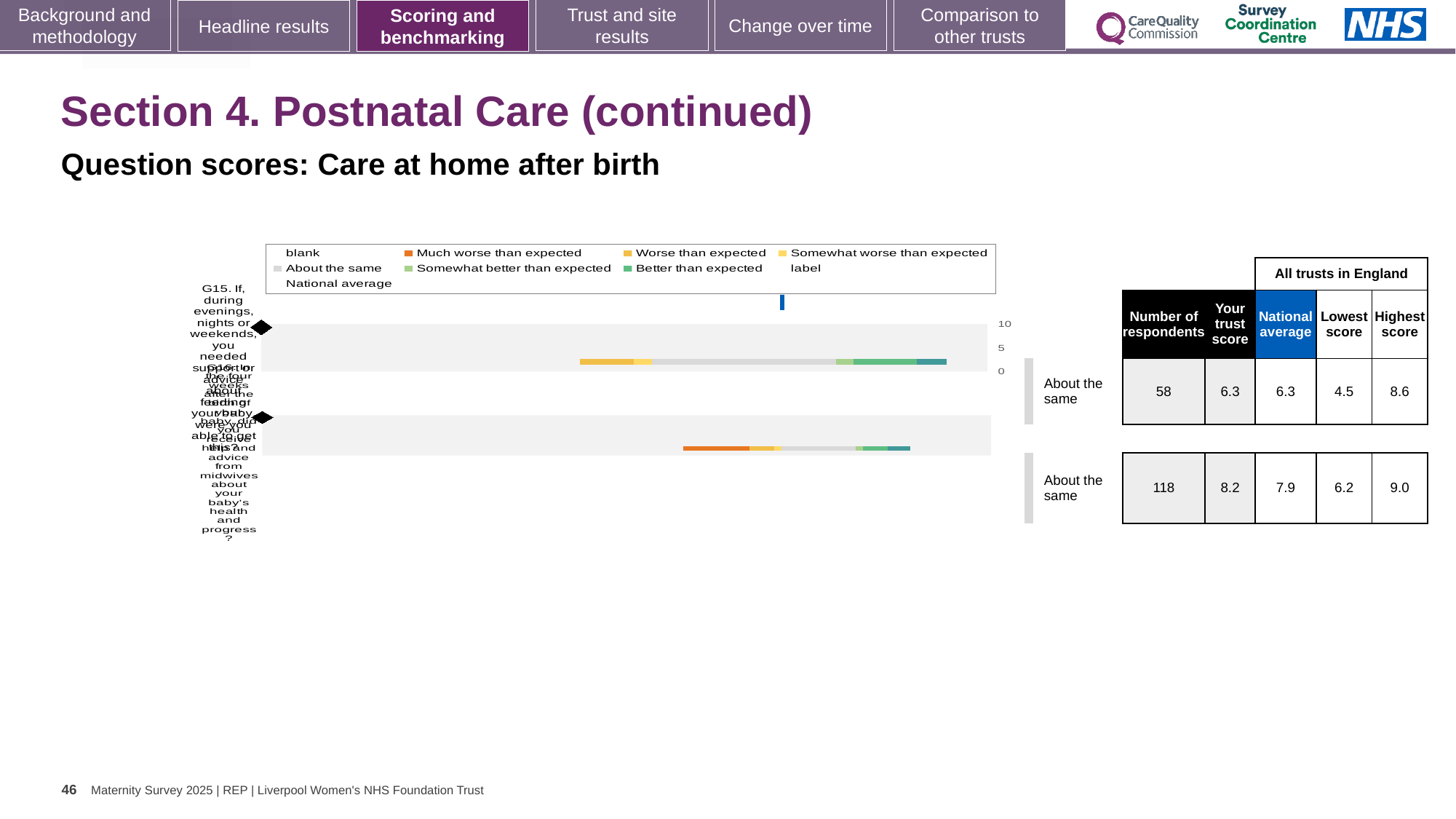
What is the highest score among all trusts in England for the second (bottom) question? 9.0 What benchmark category is shown for both questions in the chart? About the same What is the trust score for the first (top) question, G15, about getting support or advice about feeding your baby? 6.3 What kind of chart is shown on the slide? bar chart What is the difference between the highest and lowest scores for the first (top) question? 4.1 For the second (bottom) question, which is larger: the trust score or the national average? trust score What is the national average for the first (top) question in the chart? 6.3 What is the trust score for the second (bottom) question in the chart? 8.2 Which colour in the legend represents 'Much worse than expected'? orange How many respondents answered the second (bottom) question in the chart? 118 What is the difference between the trust score and the national average for the second (bottom) question? 0.3 How many questions (bars) are plotted in the chart? 2